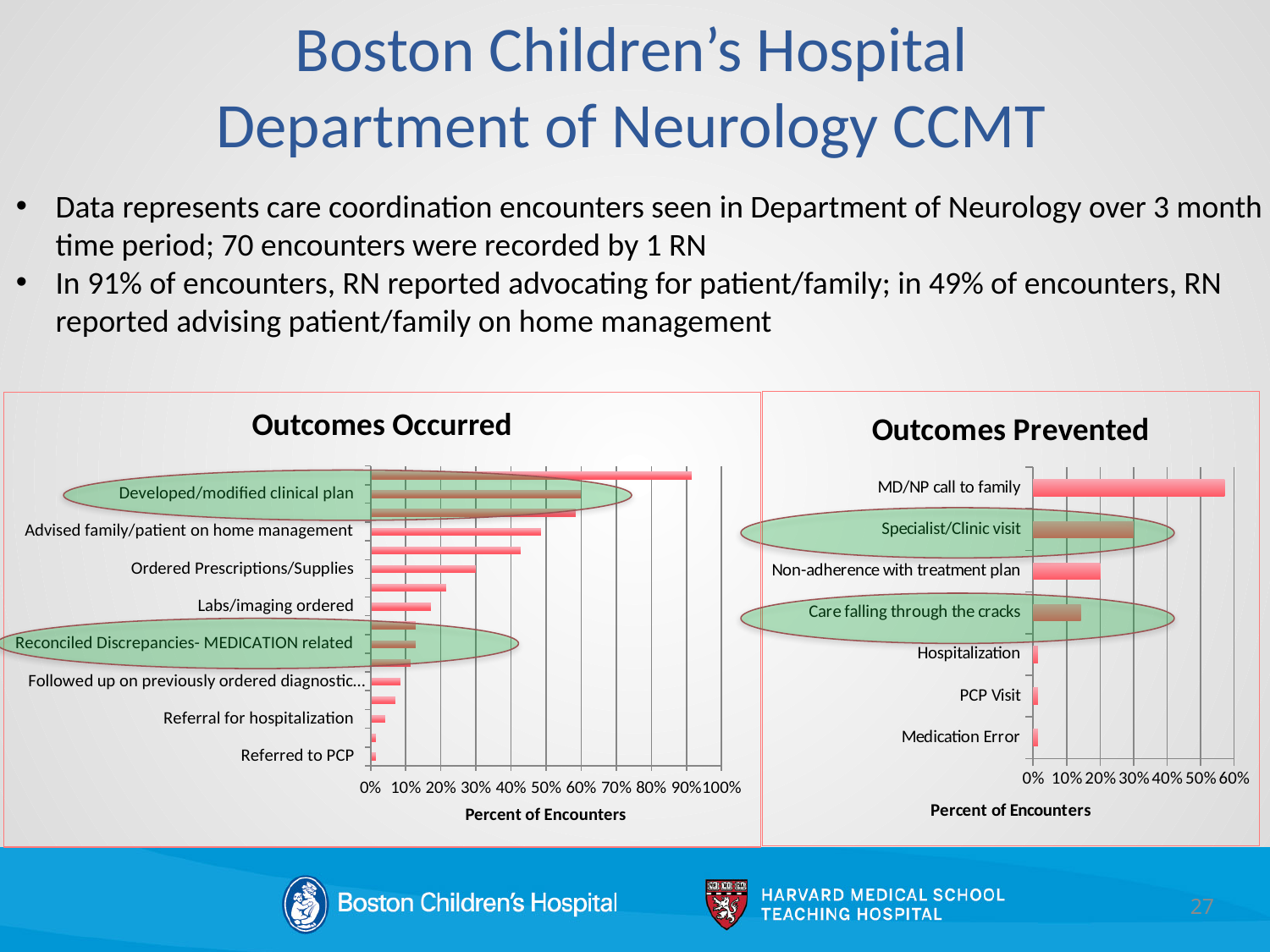
What kind of chart is the "Outcomes Prevented" chart? bar chart In the "Outcomes Prevented" chart, is the value for MD/NP call to family greater or less than 50%? greater In the "Outcomes Occurred" chart, which is larger: Advised family/patient on home management or Labs/imaging ordered? Advised family/patient on home management What is the x-axis title of the "Outcomes Occurred" chart? Percent of Encounters In the "Outcomes Prevented" chart, which is larger: Non-adherence with treatment plan or Care falling through the cracks? Non-adherence with treatment plan In the "Outcomes Prevented" chart, is the value for Specialist/Clinic visit greater or less than 40%? less In the "Outcomes Occurred" chart, is the value for Advised family/patient on home management greater or less than 40%? greater How many categories are shown in the "Outcomes Prevented" chart? 7 In the "Outcomes Prevented" chart, which category has the highest value? MD/NP call to family What is the title of the chart on the right side of the slide? Outcomes Prevented